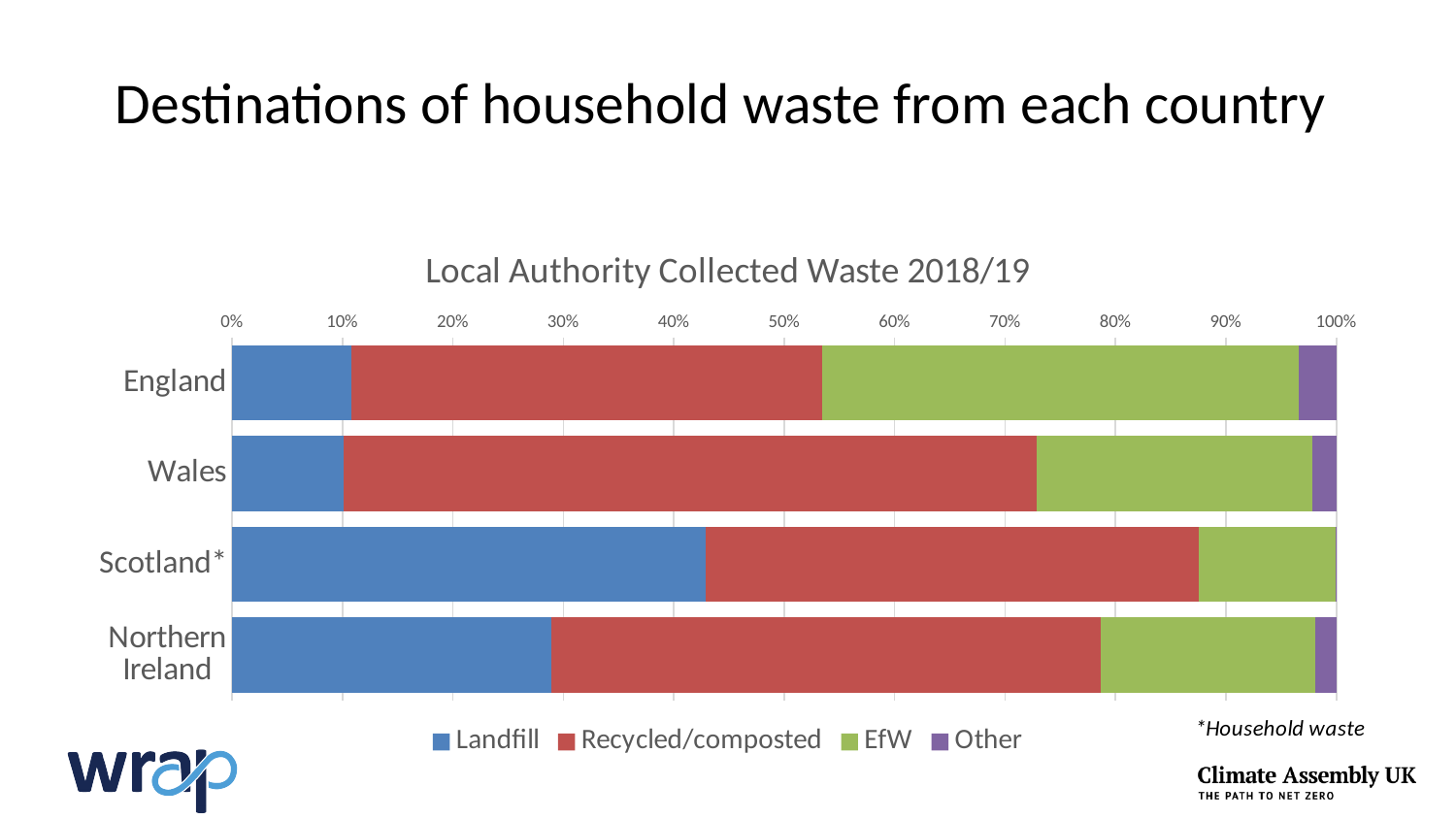
Is the Landfill share for Scotland* greater or less than 40%? greater How many countries are shown on the chart? 4 Which country has the largest Recycled/composted share? Wales Which country has the largest EfW share? England Which has the larger Landfill share, Scotland* or Northern Ireland? Scotland* Is the Landfill share for Northern Ireland greater or less than 20%? greater How many series does the legend list? 4 What kind of chart is shown on the slide? Stacked bar chart Is the Landfill share for England greater or less than 20%? less Which country has the largest Landfill share? Scotland* What is the title printed above the chart? Local Authority Collected Waste 2018/19 Which country has the smallest EfW share? Scotland*